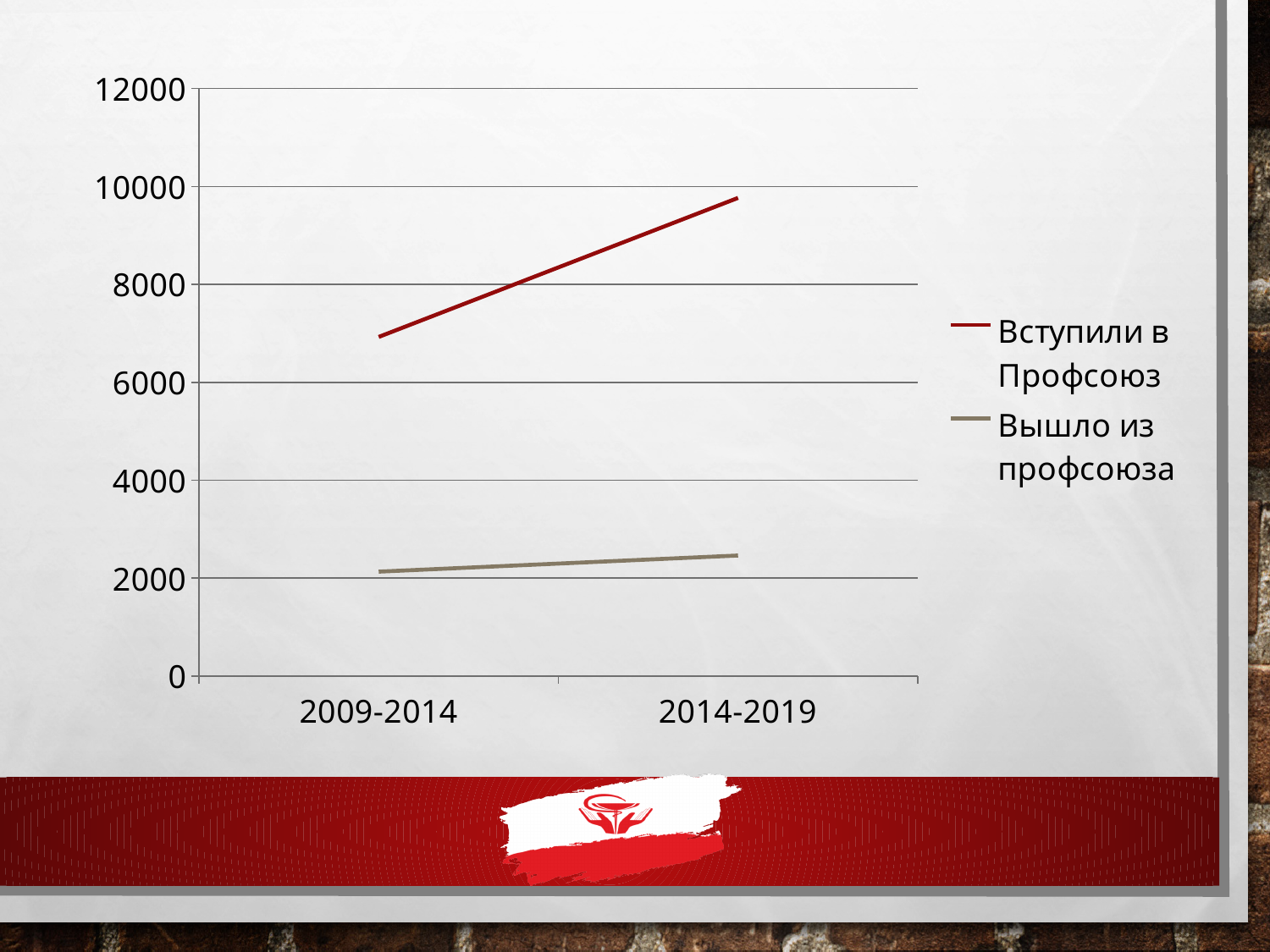
What are the two categories on the x axis? 2009-2014 and 2014-2019 Which series is drawn in red? Вступили в Профсоюз Does the value for Вступили в Профсоюз rise or fall from 2009-2014 to 2014-2019? rise In 2014-2019, which series has the larger value, Вступили в Профсоюз or Вышло из профсоюза? Вступили в Профсоюз Is the value for Вступили в Профсоюз in 2009-2014 greater or less than 6000? greater What kind of chart is shown on the slide? line chart How many categories are shown on the x axis? 2 Which series has the lower value in 2009-2014? Вышло из профсоюза Is the value for Вышло из профсоюза in 2014-2019 greater or less than 4000? less Does the value for Вышло из профсоюза rise or fall from 2009-2014 to 2014-2019? rise Is the value for Вступили в Профсоюз in 2014-2019 greater or less than 10000? less How many series does the legend list? 2